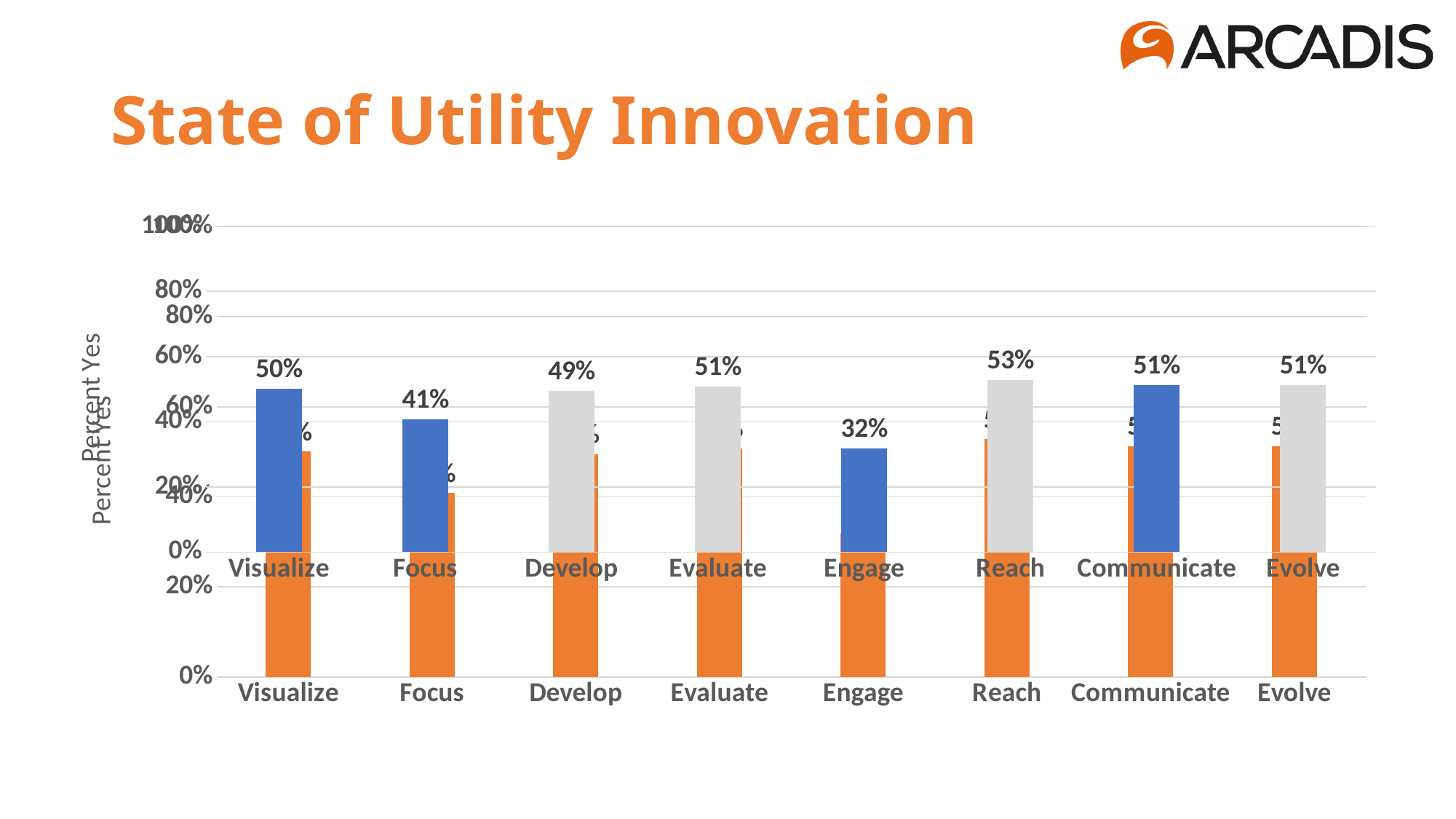
In the chart with blue and grey bars, what is the value for Engage? 32% In the chart with blue and grey bars, what is the value for Reach? 53% What kind of chart is the chart with blue and grey bars? bar chart In the chart with blue and grey bars, which category has the highest value? Reach How many categories are shown on the x axis of the chart with blue and grey bars? 8 In the chart with blue and grey bars, what is the value for Develop? 49% In the chart with blue and grey bars, which is larger, the value for Visualize or the value for Focus? Visualize In the chart with blue and grey bars, what is the difference between the values for Reach and Engage? 21% In the chart with blue and grey bars, what is the value for Focus? 41% What is the y-axis title of the charts on the slide? Percent Yes In the chart with blue and grey bars, which category has the lowest value? Engage